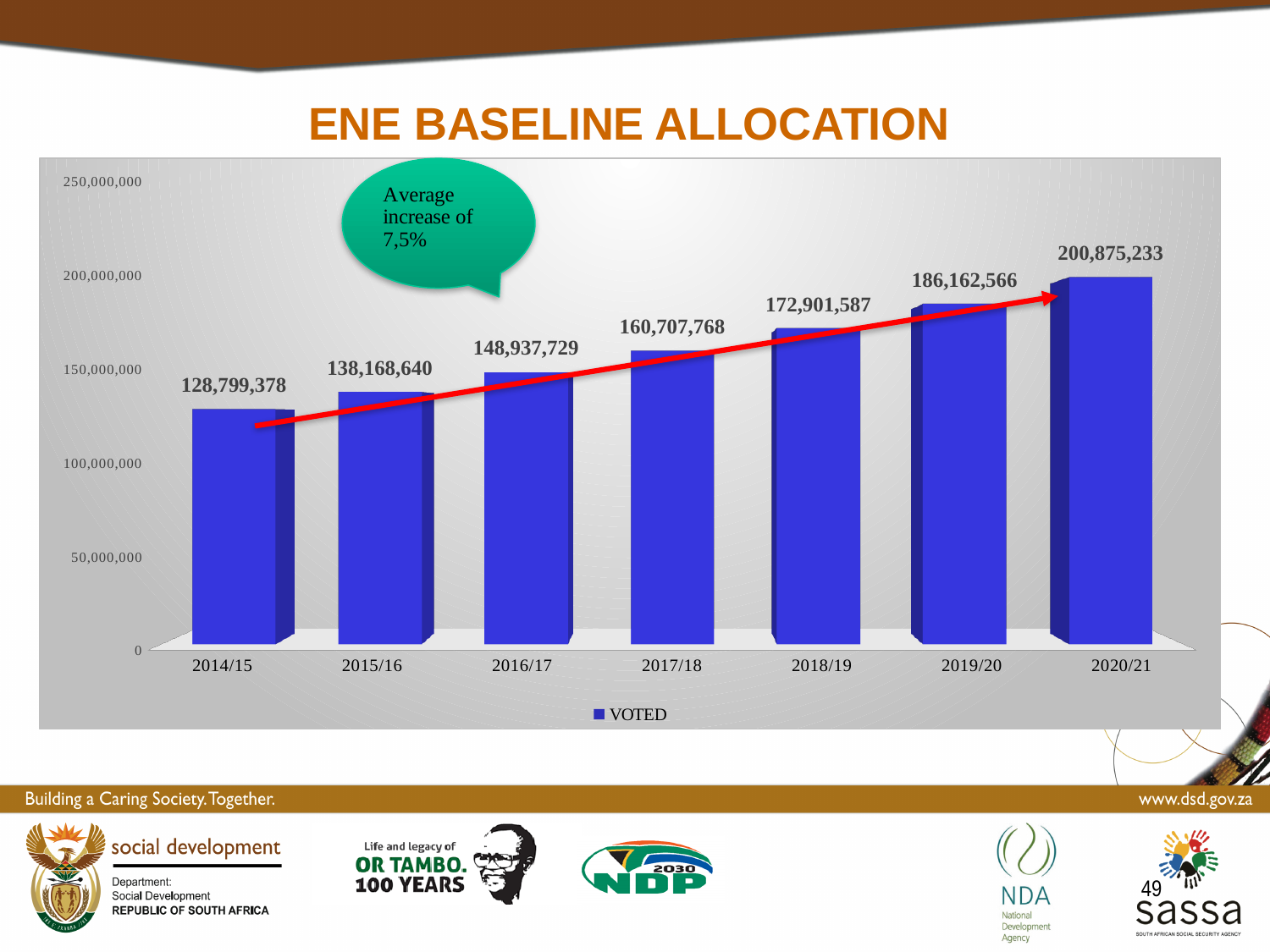
What is the VOTED value for 2014/15? 128,799,378 What is the VOTED value for 2017/18? 160,707,768 Which year has the lowest VOTED allocation? 2014/15 Is the VOTED value for 2020/21 greater or less than 200,000,000? greater Which is larger, the VOTED value for 2016/17 or for 2018/19? 2018/19 What is the difference between the VOTED values for 2019/20 and 2018/19? 13,260,979 Which year has the highest VOTED allocation? 2020/21 What is the VOTED value for 2019/20? 186,162,566 How many years are shown on the x axis? 7 What is the difference between the VOTED values for 2020/21 and 2014/15? 72,075,855 What kind of chart is shown on the slide? bar chart Do the VOTED values rise or fall from 2014/15 to 2020/21? rise